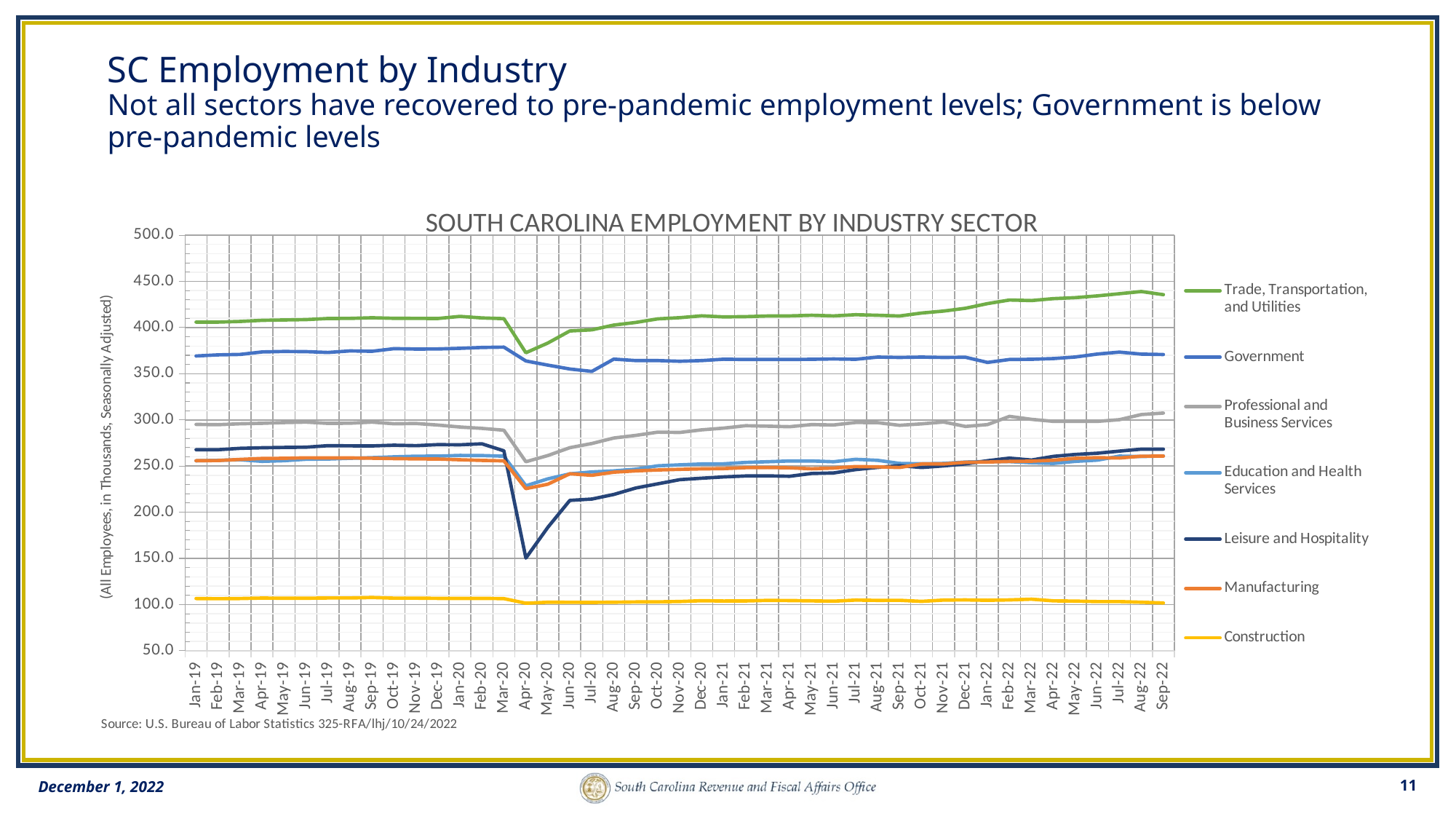
Which industry sector has the highest employment throughout the chart? Trade, Transportation, and Utilities Does the Leisure and Hospitality line rise or fall between Mar-20 and Apr-20? Fall How many series does the legend list? 7 What is the title of the chart? SOUTH CAROLINA EMPLOYMENT BY INDUSTRY SECTOR Is the value for Trade, Transportation, and Utilities in Sep-22 greater or less than 400.0? greater In Jan-19, which is larger: Government or Professional and Business Services? Government Is the value for Leisure and Hospitality in Apr-20 greater or less than 200.0? less How many monthly points are plotted along the x axis, from Jan-19 to Sep-22? 45 Is the value for Government in Sep-22 greater or less than 350.0? greater What kind of chart is shown on the slide? Line chart Which industry sector has the lowest employment throughout the chart? Construction